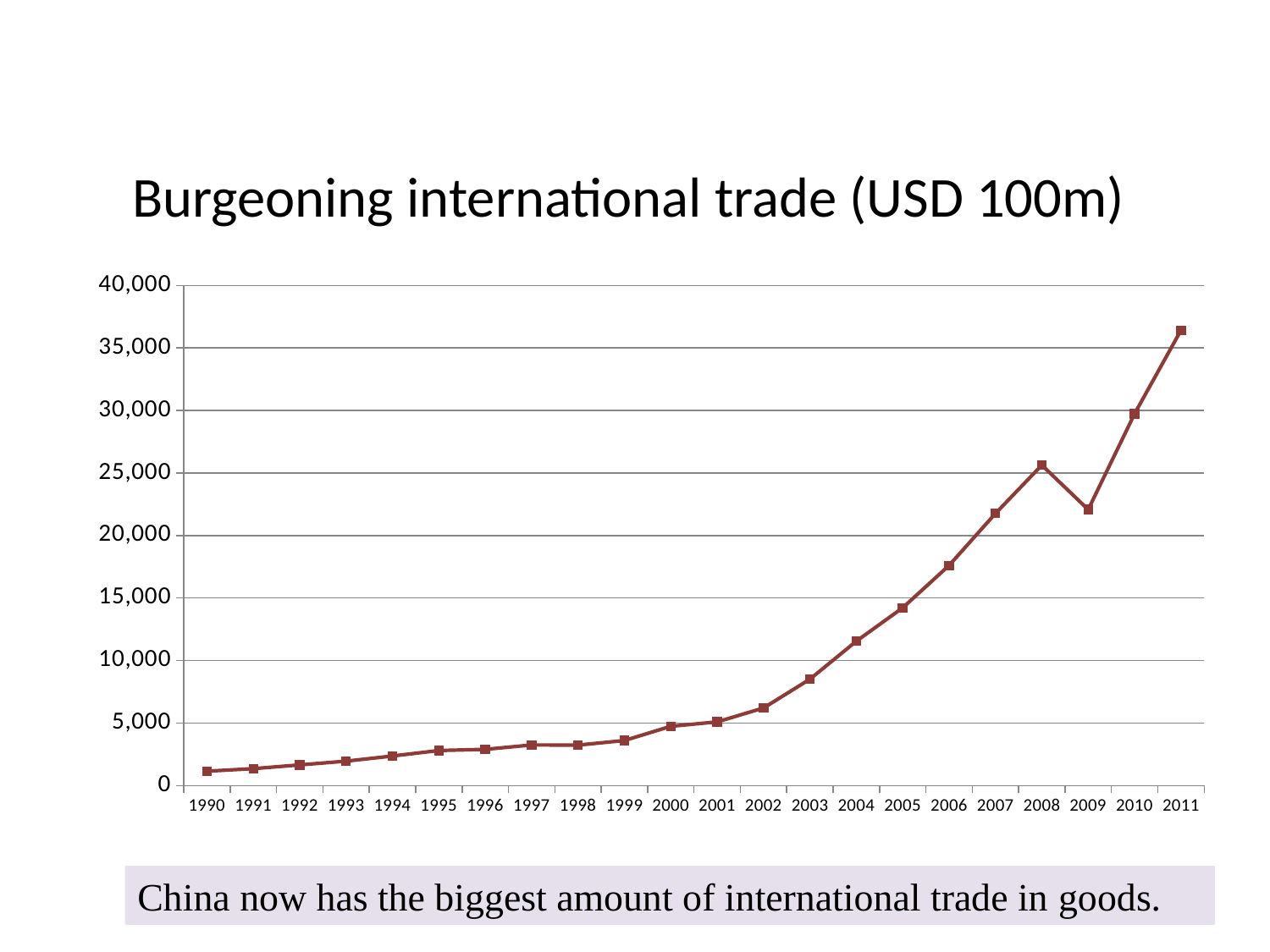
Which year has the lowest value on the chart? 1990 How many years are plotted on the x axis of the chart? 22 Which year has the highest value on the chart? 2011 Is the value for 2009 greater or less than 20,000? greater Is the value for 2003 greater or less than 10,000? less Which year has the larger value, 2009 or 2010? 2010 Is the value for 2006 greater or less than 15,000? greater What is the title of the chart? Burgeoning international trade (USD 100m) Which year has the larger value, 2008 or 2009? 2008 Do the values generally rise or fall from 1990 to 2011? rise What kind of chart is shown on the slide? line chart